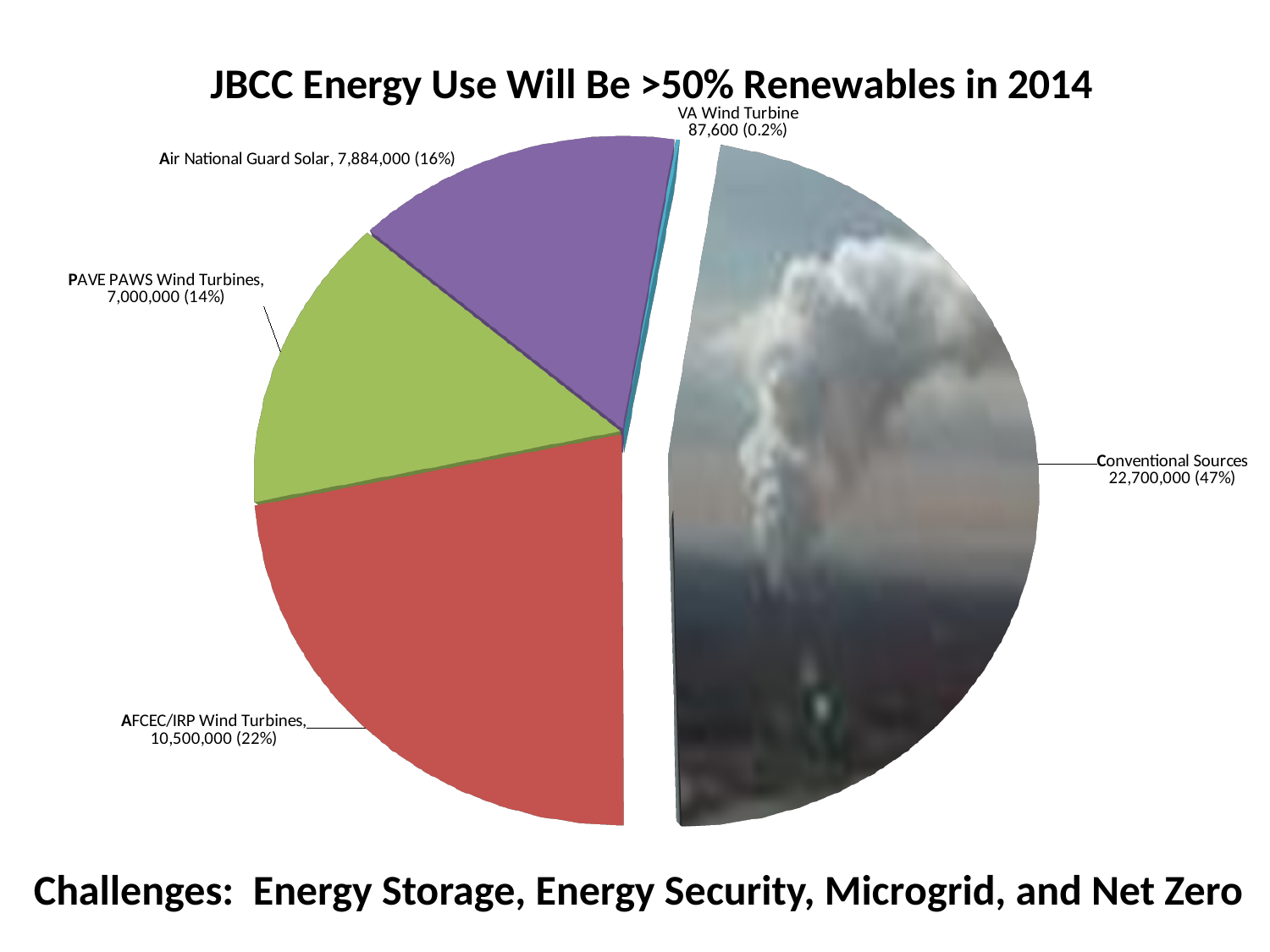
What is the difference between the values for AFCEC/IRP Wind Turbines and PAVE PAWS Wind Turbines? 3,500,000 What is the value for VA Wind Turbine? 87,600 Which slice is the smallest? VA Wind Turbine What share of the pie does PAVE PAWS Wind Turbines represent? 14% What share of the pie does Conventional Sources represent? 47% How many slices does the pie chart have? 5 What is the value for AFCEC/IRP Wind Turbines? 10,500,000 What is the value for Conventional Sources? 22,700,000 What is the value for Air National Guard Solar? 7,884,000 What is the title of the chart? JBCC Energy Use Will Be >50% Renewables in 2014 Which slice is the largest? Conventional Sources What kind of chart is shown on the slide? Pie chart